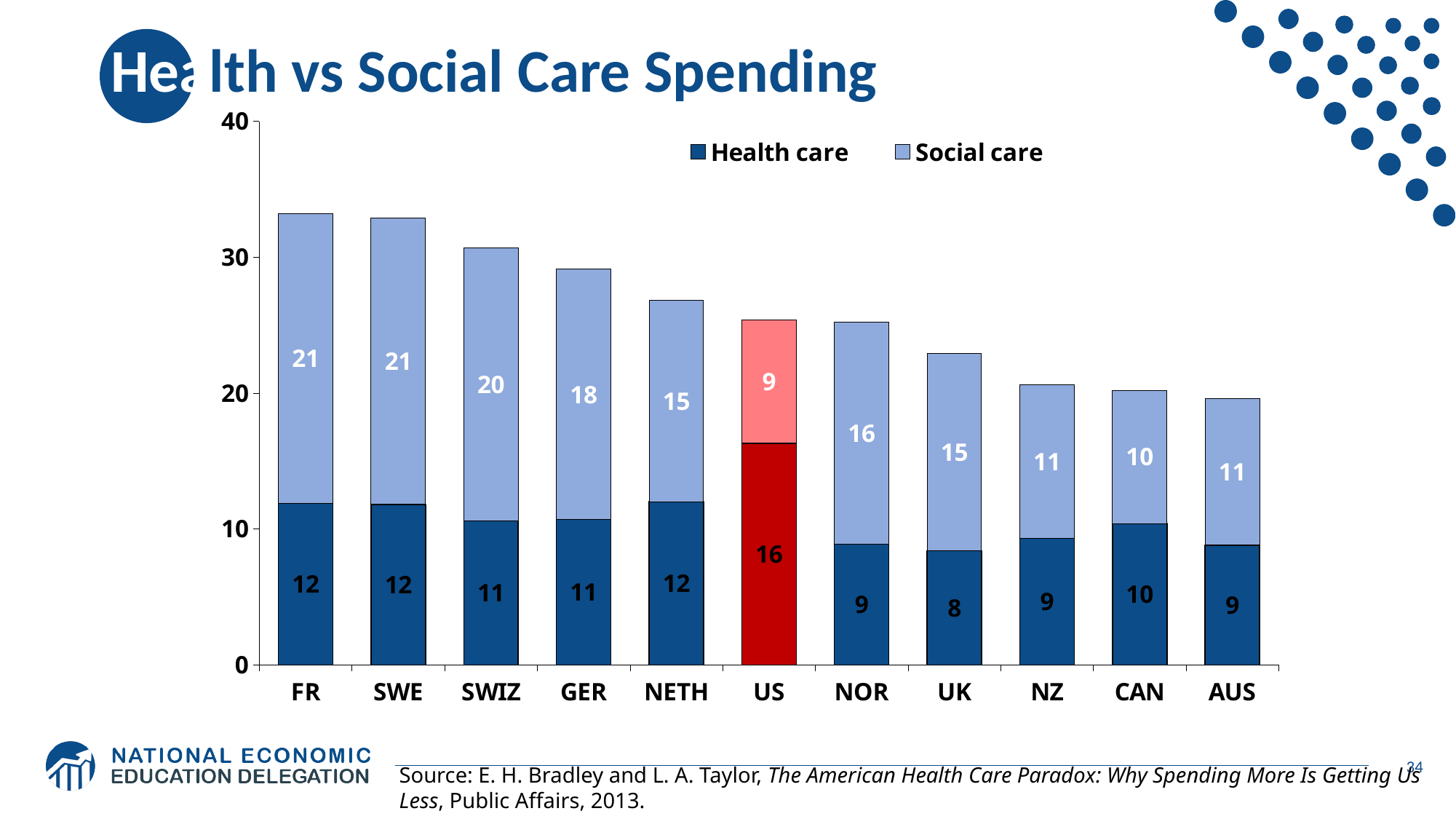
Which country has the lowest Social care value? US What is the difference between the Health care value for the US and the Health care value for the UK? 8 Which country has the lowest Health care value? UK Which is larger: the Social care value for FR or the Social care value for the US? FR What is the Health care value for the US? 16 Is the total height of the FR bar greater or less than 30? greater What is the Social care value for Germany (GER)? 18 How many countries are shown on the x axis? 11 How many series does the legend list? 2 Which country has the highest Health care value? US Which country's bar is highlighted in red? US What kind of chart is shown on the slide? Stacked bar chart